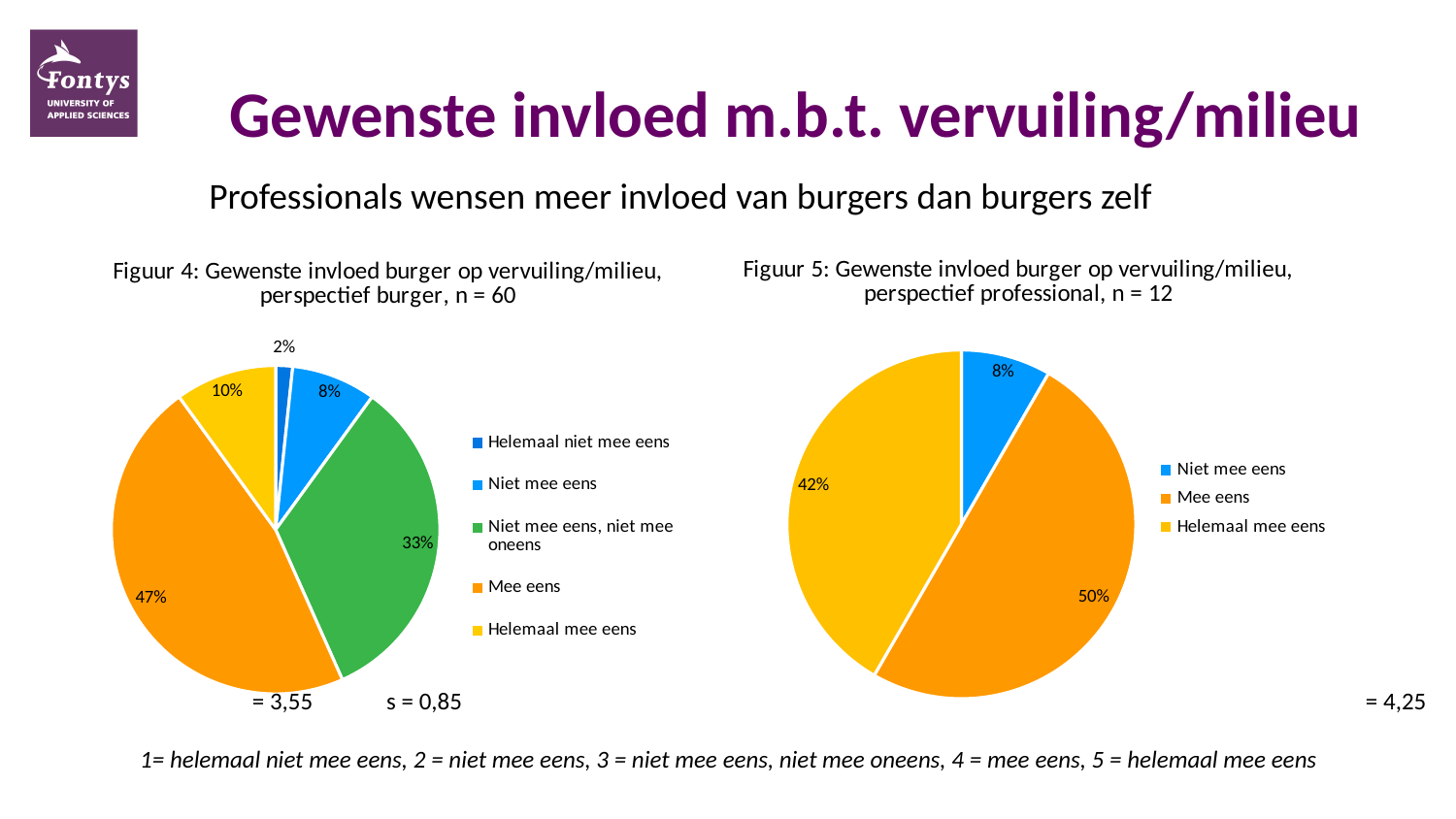
What type of chart is Figuur 5 (perspectief professional)? Pie chart In Figuur 4 (perspectief burger), what share of the pie is 'Mee eens'? 47% In Figuur 5 (perspectief professional), which is larger: 'Niet mee eens' or 'Helemaal mee eens'? Helemaal mee eens In Figuur 4 (perspectief burger), what is the difference in percentage points between 'Mee eens' and 'Niet mee eens, niet mee oneens'? 14 In Figuur 4 (perspectief burger), what colour is the 'Helemaal mee eens' slice? Yellow In Figuur 4 (perspectief burger), what percentage is shown for 'Niet mee eens, niet mee oneens'? 33% In Figuur 4 (perspectief burger), which category has the smallest slice? Helemaal niet mee eens In Figuur 5 (perspectief professional), which category has the largest slice? Mee eens In Figuur 5 (perspectief professional), how many categories does the legend list? 3 In Figuur 4 (perspectief burger), how many categories does the legend list? 5 In Figuur 5 (perspectief professional), what share of the pie is 'Helemaal mee eens'? 42% In Figuur 4 (perspectief burger), which category has the largest slice? Mee eens